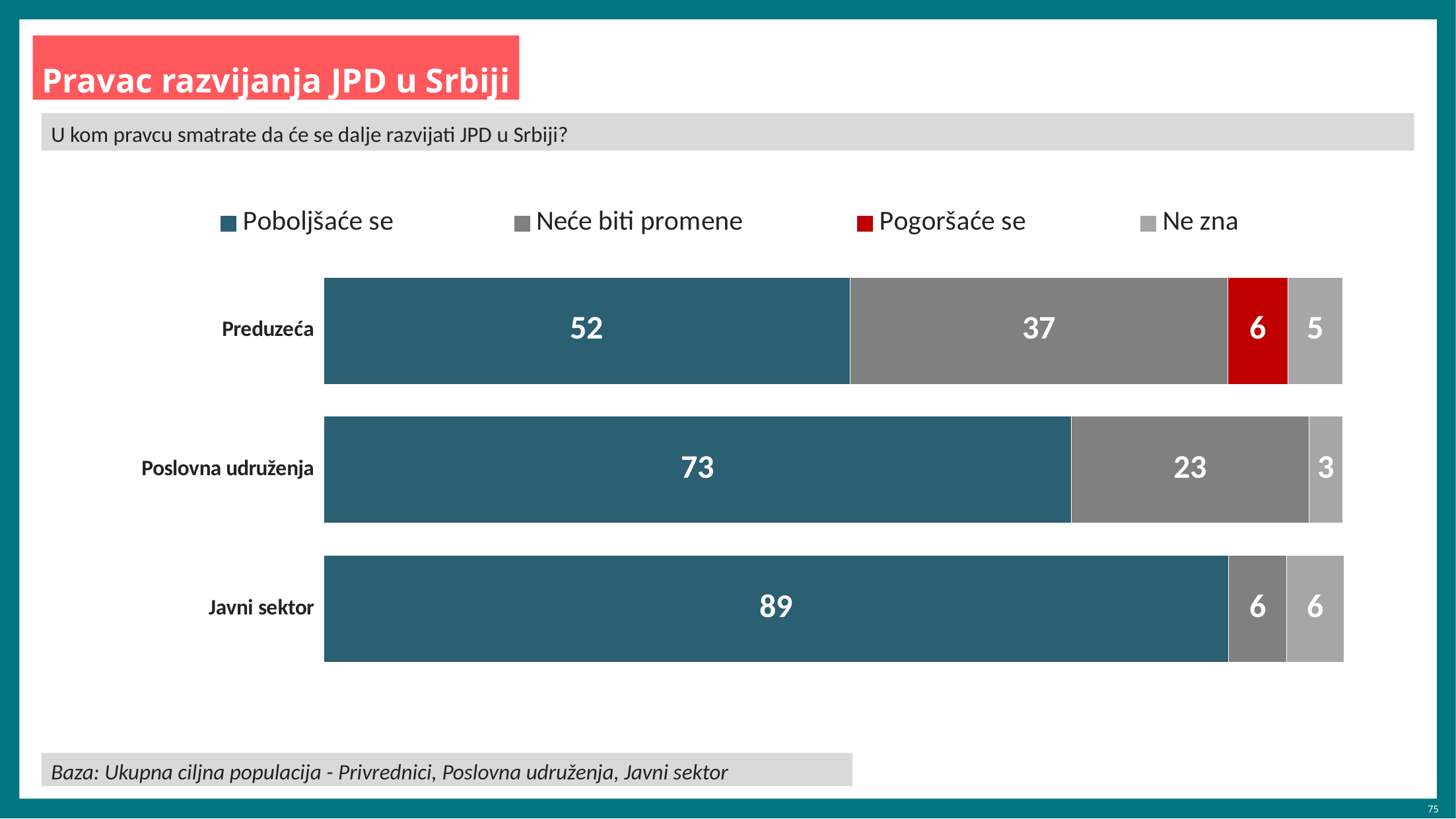
What kind of chart is shown on the slide? Stacked bar chart Which category has the lowest value for "Neće biti promene"? Javni sektor What is the value for "Ne zna" for Javni sektor? 6 What is the total of the stacked bar for Poslovna udruženja? 99 What is the value for "Poboljšaće se" for Preduzeća? 52 How many categories are shown on the chart? 3 What is the difference between the "Poboljšaće se" values for Javni sektor and Preduzeća? 37 What is the value for "Neće biti promene" for Poslovna udruženja? 23 Which is larger: the "Neće biti promene" value for Preduzeća or for Poslovna udruženja? Preduzeća Which category has the highest value for "Poboljšaće se"? Javni sektor What is the value for "Pogoršaće se" for Preduzeća? 6 How many series does the legend list? 4